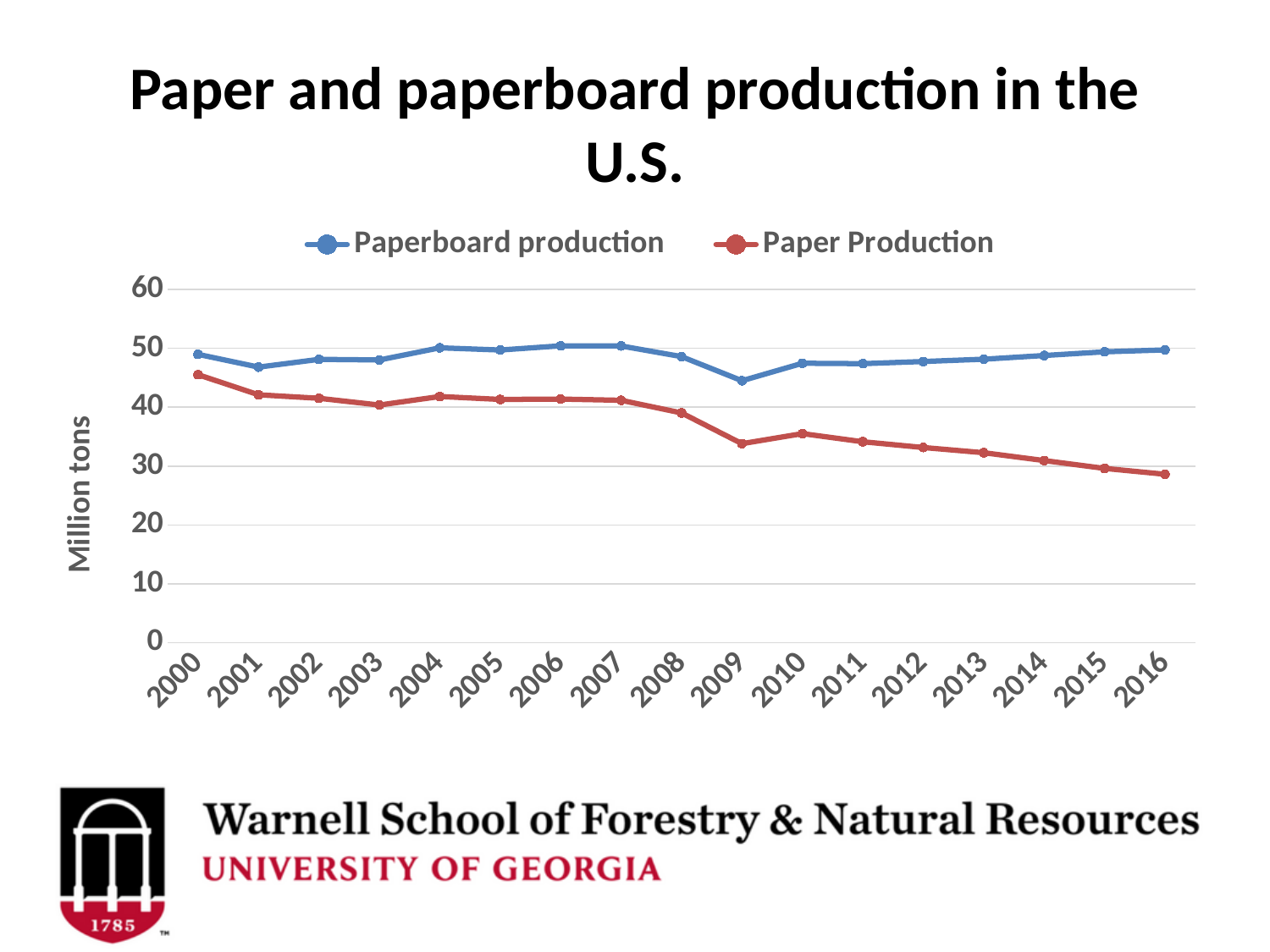
What is the label on the y axis? Million tons Is the value for Paperboard production in 2009 greater or less than 50? less In which year is Paper Production highest? 2000 Is the value for Paper Production in 2016 greater or less than 30? less In which year is Paper Production lowest? 2016 In which year is Paperboard production lowest? 2009 How many series does the legend list? 2 How many years are plotted along the x axis? 17 Does Paper Production rise or fall from 2000 to 2016? fall Is the value for Paper Production in 2000 greater or less than 40? greater What kind of chart is shown on the slide? line chart Which series is higher in 2016, Paperboard production or Paper Production? Paperboard production